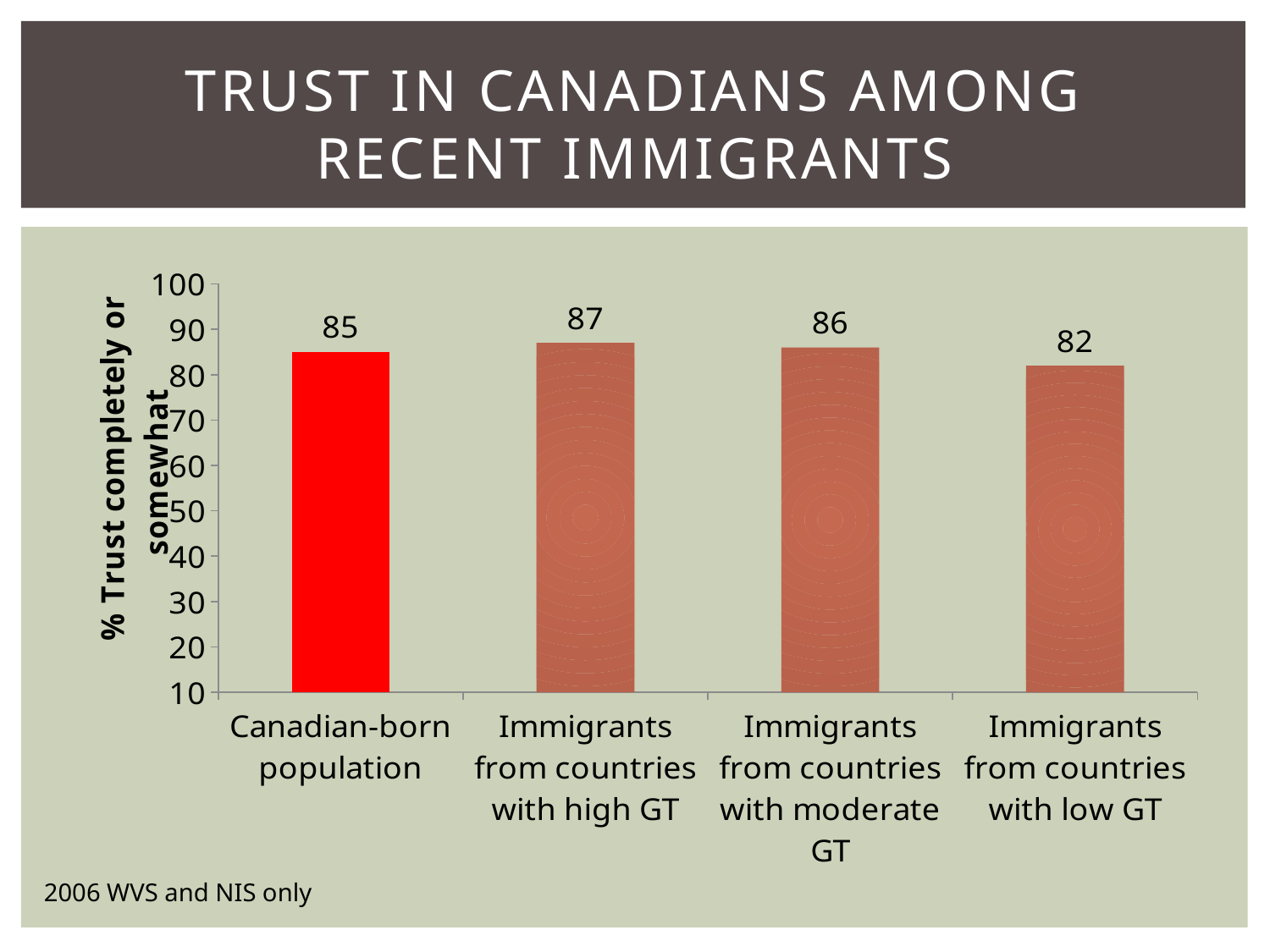
Which bar is coloured bright red, unlike the others? Canadian-born population How many categories are shown on the chart? 4 What is the value for the Canadian-born population? 85 What is the value for immigrants from countries with high GT? 87 Which category has the highest value? Immigrants from countries with high GT Which category has the lowest value? Immigrants from countries with low GT What is the value for immigrants from countries with low GT? 82 Which is larger: the value for the Canadian-born population or the value for immigrants from countries with low GT? Canadian-born population What is the title of the chart on the slide? Trust in Canadians among recent immigrants What kind of chart is shown on the slide? Bar chart What is the difference between the values for immigrants from countries with high GT and immigrants from countries with low GT? 5 What is the value for immigrants from countries with moderate GT? 86